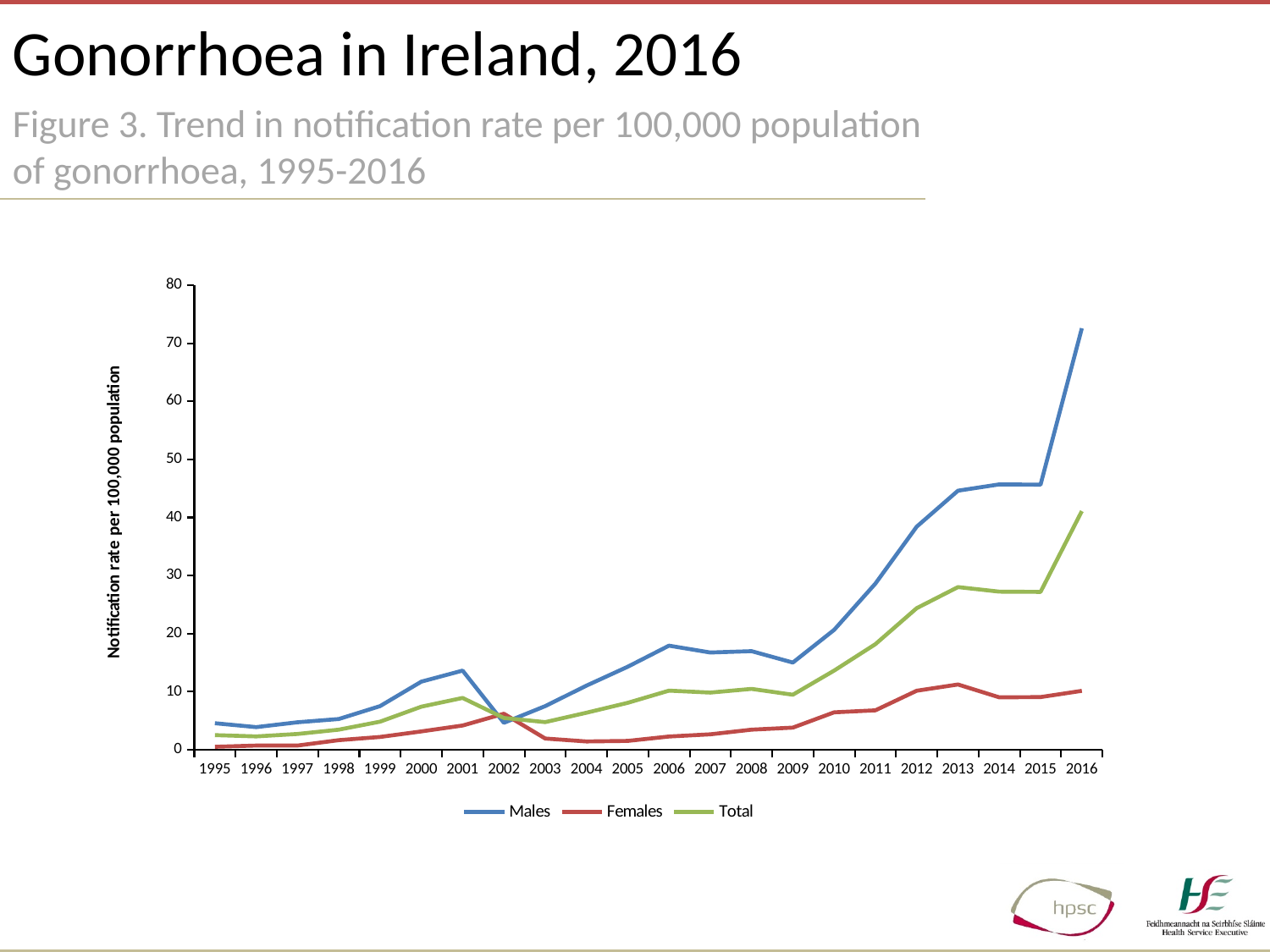
What kind of chart is shown on the slide? line chart Does the Males series rise or fall between 2013 and 2016? rise What are the three entries in the legend? Males, Females, Total Is the value for Males in 2016 greater or less than 60? greater Is the value for Males in 2009 greater or less than 20? less Is the value for Females in 2013 greater or less than 20? less In which year does the Males series reach its highest value? 2016 Which series has the lowest value in 2016? Females Which is larger in 2016, the value for Males or the value for Females? Males How many series does the legend list? 3 How many years are plotted along the x axis? 22